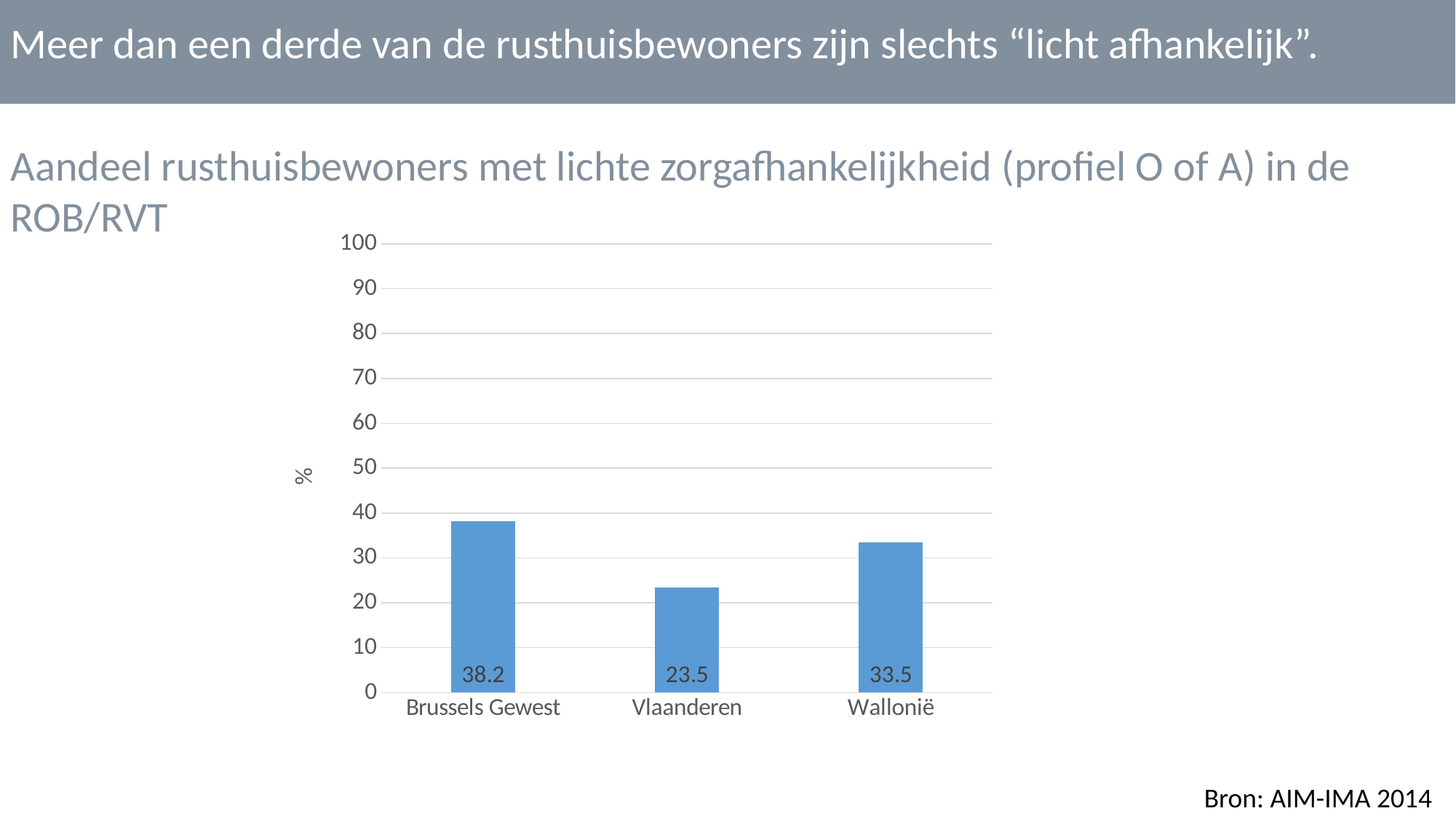
Is the value for Vlaanderen greater or less than 30? less What is the value for Brussels Gewest? 38.2 What is the label on the vertical axis? % What is the difference between the values for Wallonië and Vlaanderen? 10.0 What is the value for Wallonië? 33.5 Which is larger, the value for Wallonië or the value for Vlaanderen? Wallonië What is the value for Vlaanderen? 23.5 What is the difference between the values for Brussels Gewest and Vlaanderen? 14.7 What kind of chart is shown on the slide? bar chart How many regions are shown in the chart? 3 Which region has the highest share of residents with light care dependency? Brussels Gewest Which region has the lowest value? Vlaanderen